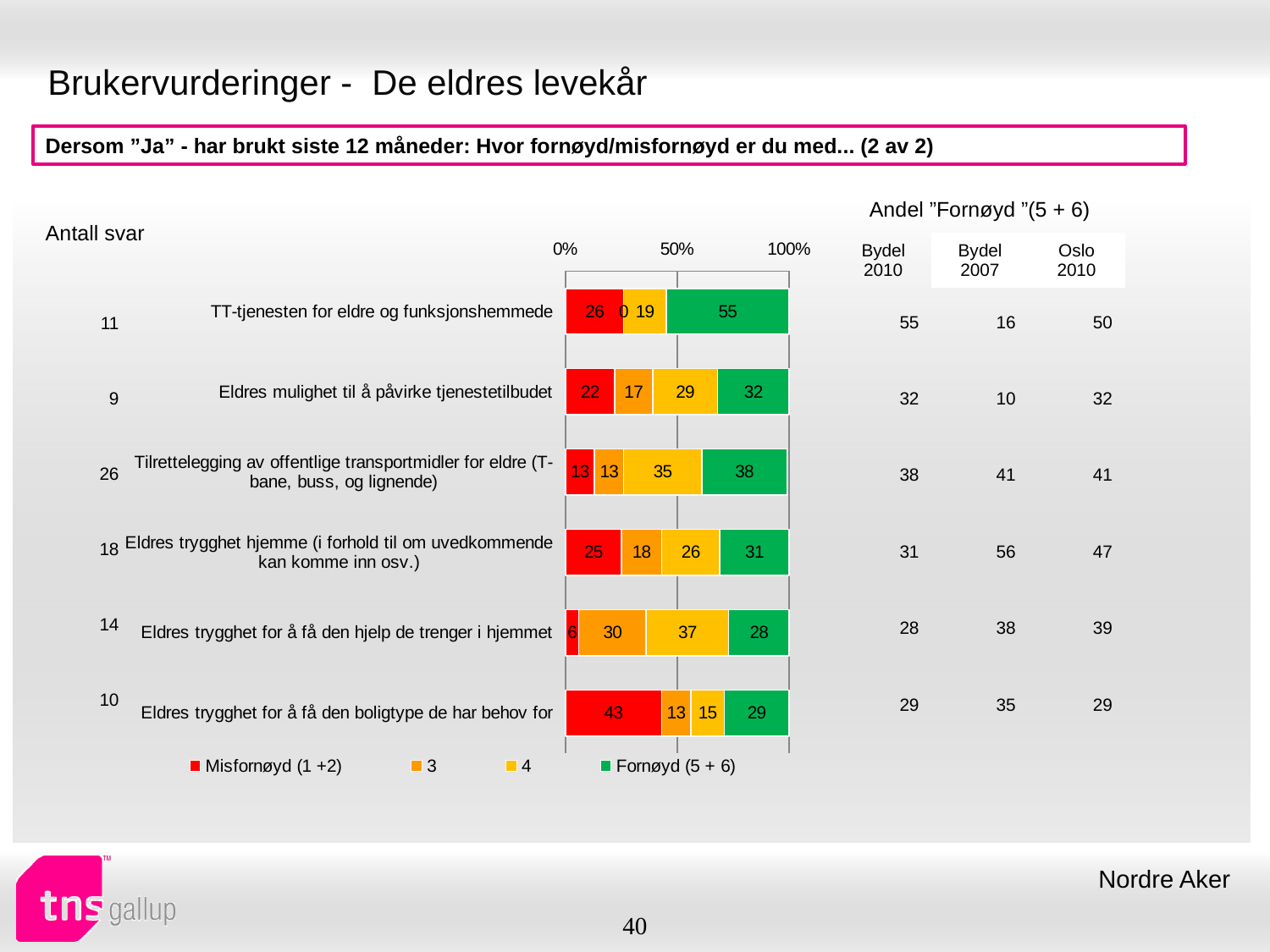
How many categories are plotted in the chart? 6 How many series does the chart legend list? 4 Which has a larger Misfornøyd (1 +2) value: 'Eldres trygghet hjemme (i forhold til om uvedkommende kan komme inn osv.)' or 'Eldres mulighet til å påvirke tjenestetilbudet'? Eldres trygghet hjemme (i forhold til om uvedkommende kan komme inn osv.) What kind of chart is shown on the slide? Stacked bar chart Which category has the lowest Misfornøyd (1 +2) value? Eldres trygghet for å få den hjelp de trenger i hjemmet What is the Misfornøyd (1 +2) value for 'Eldres trygghet for å få den boligtype de har behov for'? 43 Which category has the highest Fornøyd (5 + 6) value? TT-tjenesten for eldre og funksjonshemmede What is the difference between the Fornøyd (5 + 6) values for 'TT-tjenesten for eldre og funksjonshemmede' and 'Eldres mulighet til å påvirke tjenestetilbudet'? 23 What is the Fornøyd (5 + 6) value for 'TT-tjenesten for eldre og funksjonshemmede'? 55 What is the value of series '4' for 'Tilrettelegging av offentlige transportmidler for eldre (T-bane, buss, og lignende)'? 35 What is the total of the stacked bar for 'Eldres trygghet for å få den boligtype de har behov for'? 100 Which colour represents the Fornøyd (5 + 6) series in the chart? Green